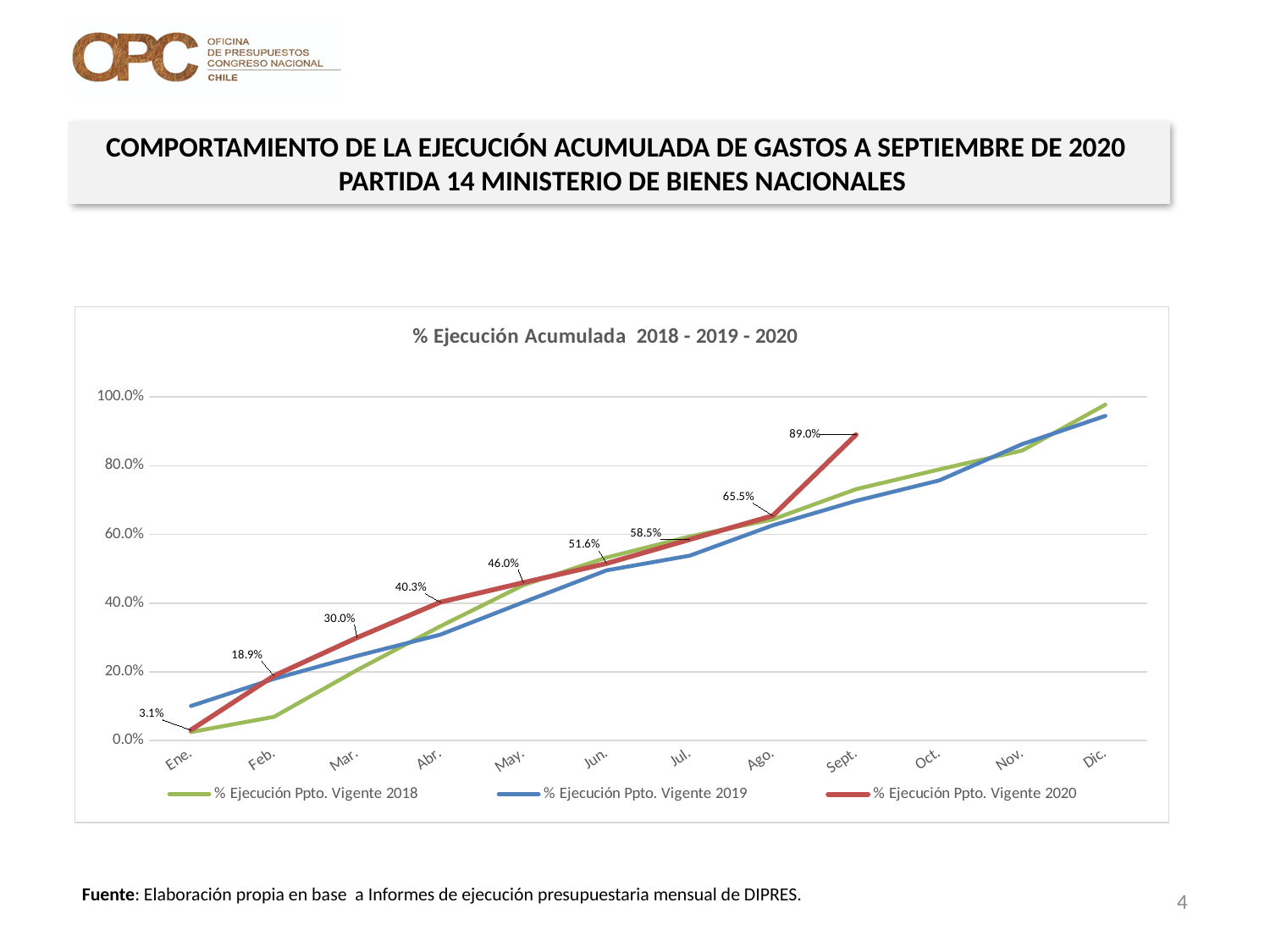
What is the difference between the 2020 values for Feb. and Ene.? 15.8% In which month does the % Ejecución Ppto. Vigente 2020 series reach its lowest value? Ene. Does the % Ejecución Ppto. Vigente 2020 series rise or fall from Ene. to Sept.? rise What is the value for % Ejecución Ppto. Vigente 2020 in Sept.? 89.0% What is the value for % Ejecución Ppto. Vigente 2020 in Jun.? 51.6% How many months are shown on the x axis? 12 Is the value for % Ejecución Ppto. Vigente 2019 in Ene. greater or less than 20.0%? less What type of chart is shown on the slide? line chart In Sept., which series has the larger value: % Ejecución Ppto. Vigente 2020 or % Ejecución Ppto. Vigente 2019? % Ejecución Ppto. Vigente 2020 What is the difference between the 2020 values for Sept. and Ago.? 23.5% How many series does the legend list? 3 What is the value for % Ejecución Ppto. Vigente 2020 in Mar.? 30.0%